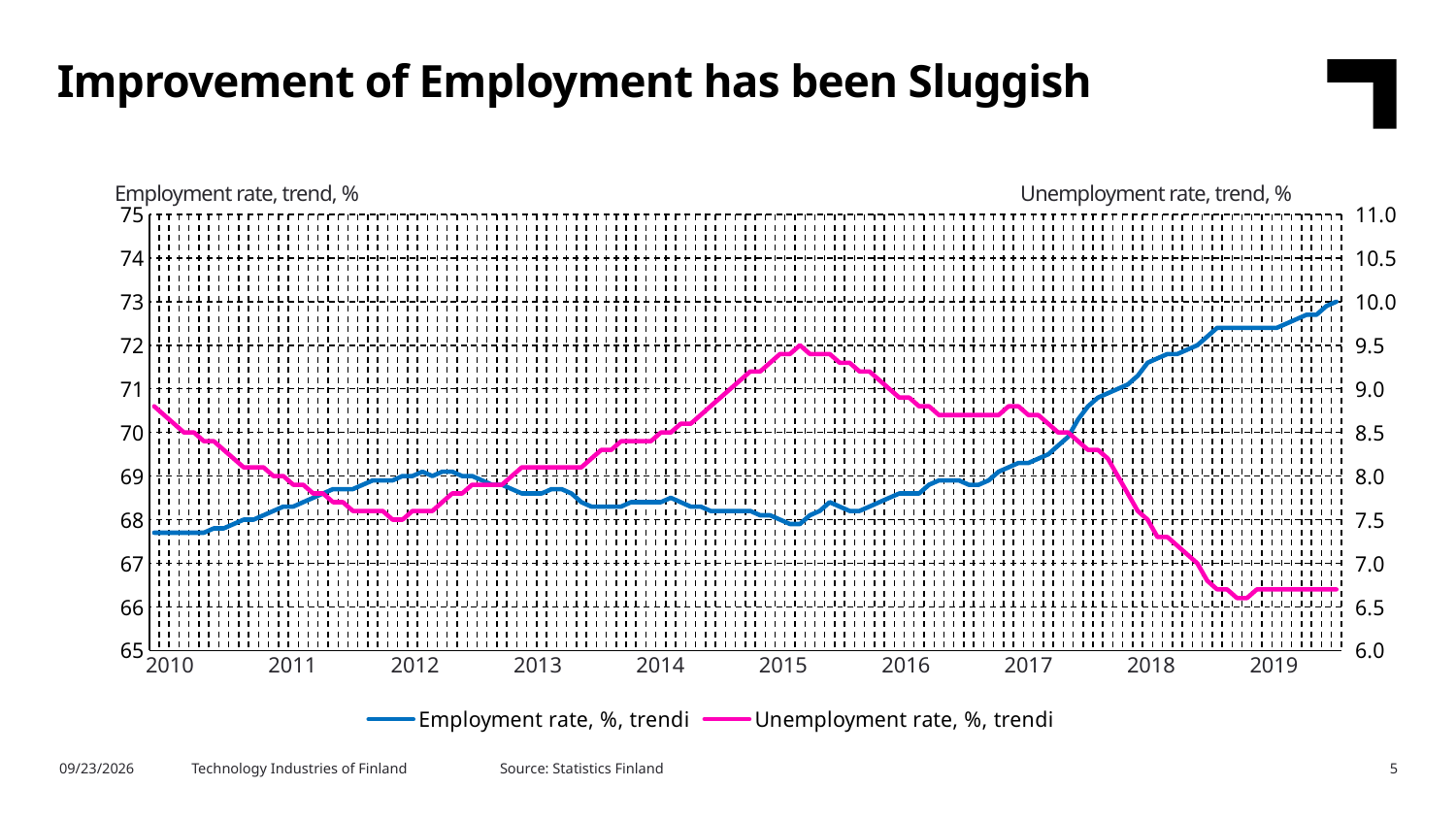
Does the unemployment rate line rise or fall between 2012 and 2015? Rise Is the employment rate at the start of 2010 greater or less than 68? less Does the employment rate line rise or fall between 2017 and 2019? Rise Is the unemployment rate at the end of 2019 greater or less than 7.0? less How many year labels are shown on the x axis? 10 Does the unemployment rate line rise or fall between 2015 and 2019? Fall What is the title of the left vertical axis? Employment rate, trend, % In which year does the unemployment rate line reach its highest point? 2015 How many series does the legend list? 2 What is the title of the right vertical axis? Unemployment rate, trend, % What kind of chart is shown on the slide? Line chart